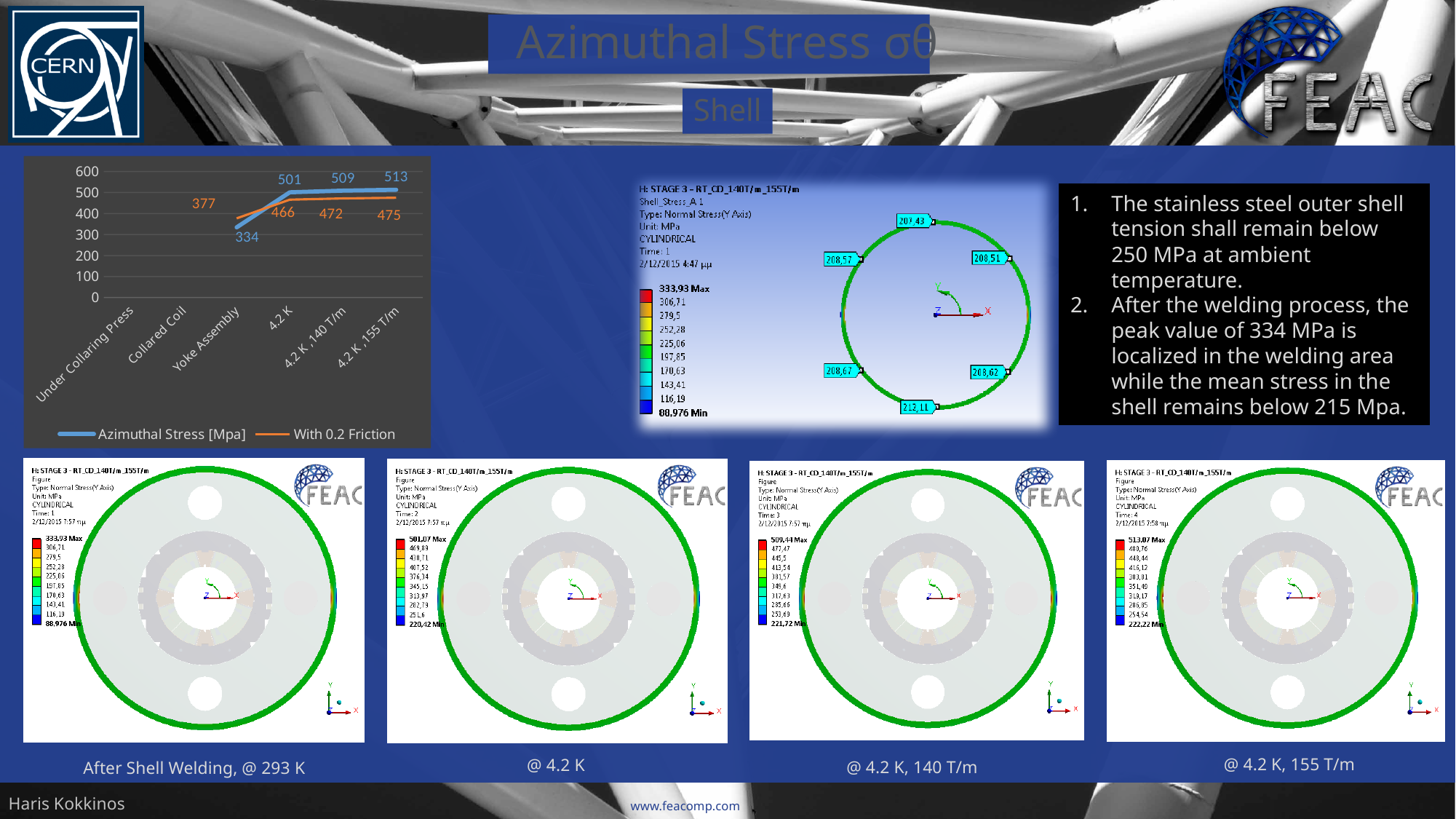
How many categories are shown on the x axis of the line chart? 6 In the line chart, does the Azimuthal Stress [Mpa] series rise or fall from Yoke Assembly to 4.2 K, 155 T/m? Rise In the line chart, what is the Azimuthal Stress [Mpa] value at Yoke Assembly? 334 How many series does the legend of the line chart list? 2 In the line chart, what is the difference between the Azimuthal Stress [Mpa] value and the With 0.2 Friction value at 4.2 K, 155 T/m? 38 What kind of chart is shown at the top left of the slide? Line chart In the line chart, how much does the Azimuthal Stress [Mpa] value increase from 4.2 K to 4.2 K, 140 T/m? 8 In the line chart, what is the With 0.2 Friction value at 4.2 K, 140 T/m? 472 In the line chart, what is the With 0.2 Friction value at 4.2 K? 466 In the line chart, at which category does the Azimuthal Stress [Mpa] series reach its highest value? 4.2 K, 155 T/m In the line chart, what is the Azimuthal Stress [Mpa] value at 4.2 K, 155 T/m? 513 In the line chart, at 4.2 K, which series has the larger value: Azimuthal Stress [Mpa] or With 0.2 Friction? Azimuthal Stress [Mpa]